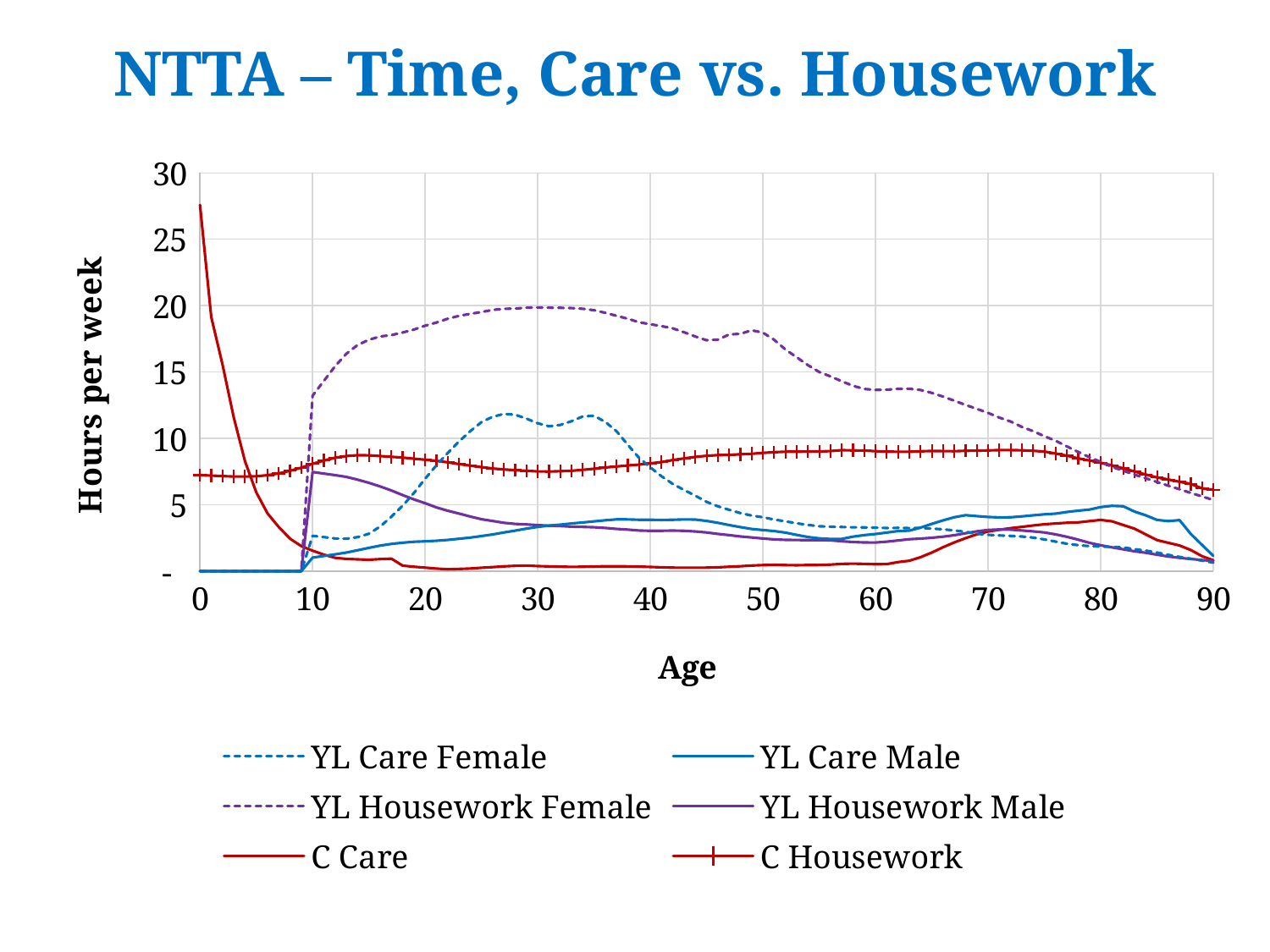
What is the label on the vertical axis? Hours per week Is the value for YL Housework Female at age 30 greater or less than 15? greater At age 30, which series is higher, YL Housework Female or YL Housework Male? YL Housework Female Which series has the highest value at age 50? YL Housework Female Does the C Care line rise or fall between age 0 and age 10? fall What kind of chart is shown on the slide? line chart What is the title of the chart? NTTA – Time, Care vs. Housework How many series does the legend list? 6 Is the value for YL Care Male at age 20 greater or less than 5? less Is the value for C Care at age 0 greater or less than 25? greater At age 20, which series is higher, YL Care Male or YL Housework Male? YL Housework Male